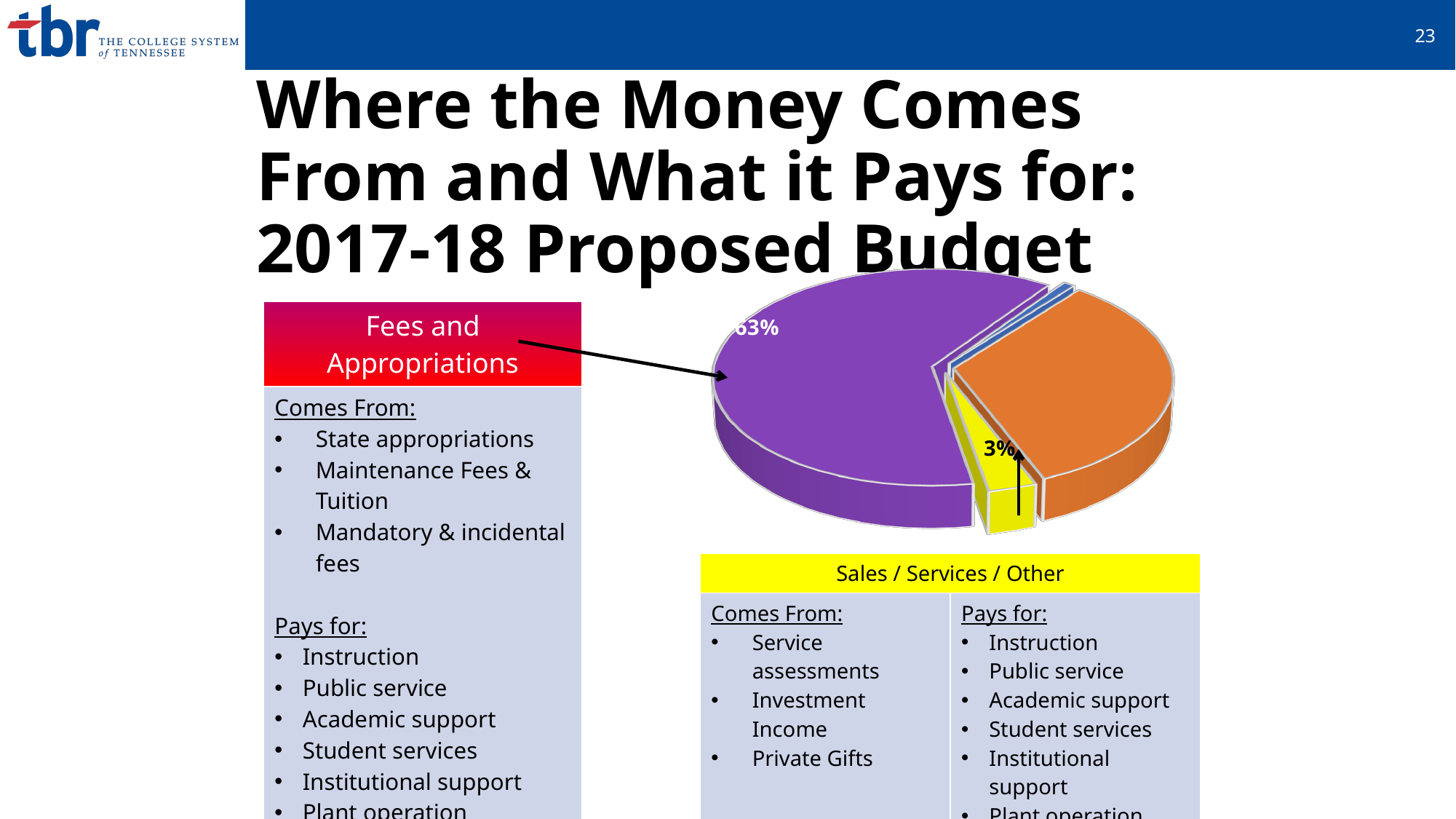
Which is larger, the Fees and Appropriations slice or the Sales / Services / Other slice? Fees and Appropriations How many slices does the pie chart have? 4 Which slice of the pie chart is the largest? Fees and Appropriations (purple, 63%) Which is larger, the purple slice or the orange slice? the purple slice What share of the pie does the Sales / Services / Other slice represent? 3% What is the difference in percentage points between the Fees and Appropriations slice and the Sales / Services / Other slice? 60 percentage points What colour is the slice labelled 63%? purple What share of the pie does the Fees and Appropriations slice represent? 63% What kind of chart is shown on the slide? pie chart What colour is the slice that the Sales / Services / Other box points to? yellow